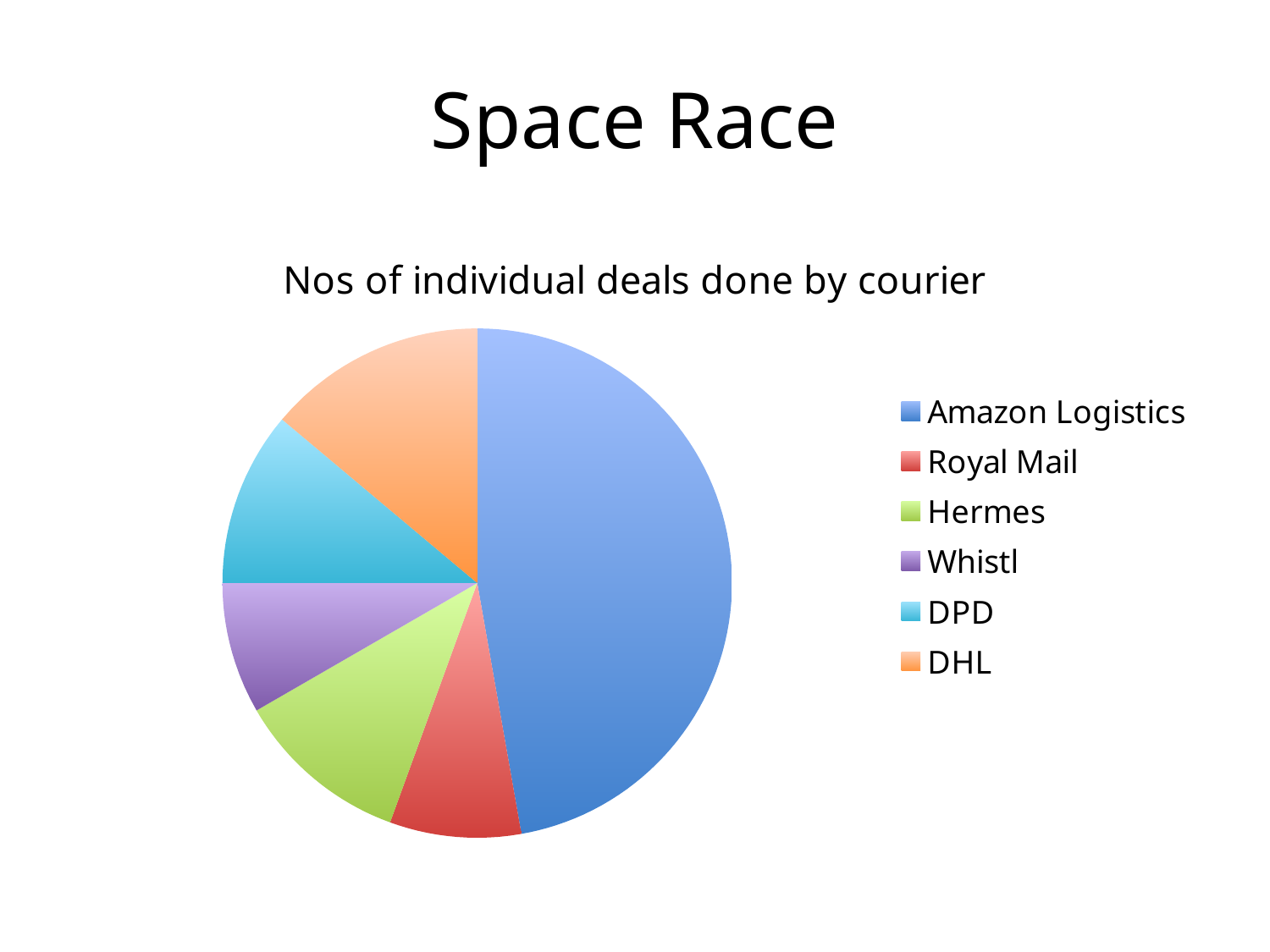
How many entries does the legend list? 6 What is the title of the chart? Nos of individual deals done by courier What kind of chart is shown on the slide? pie chart Which courier has the largest slice of the pie? Amazon Logistics Which slice is larger, Amazon Logistics or DHL? Amazon Logistics Which courier is shown in blue in the legend? Amazon Logistics Which slice is larger, Amazon Logistics or Royal Mail? Amazon Logistics How many couriers (slices) does the pie chart show? 6 Which slice is larger, Hermes or Whistl? Hermes